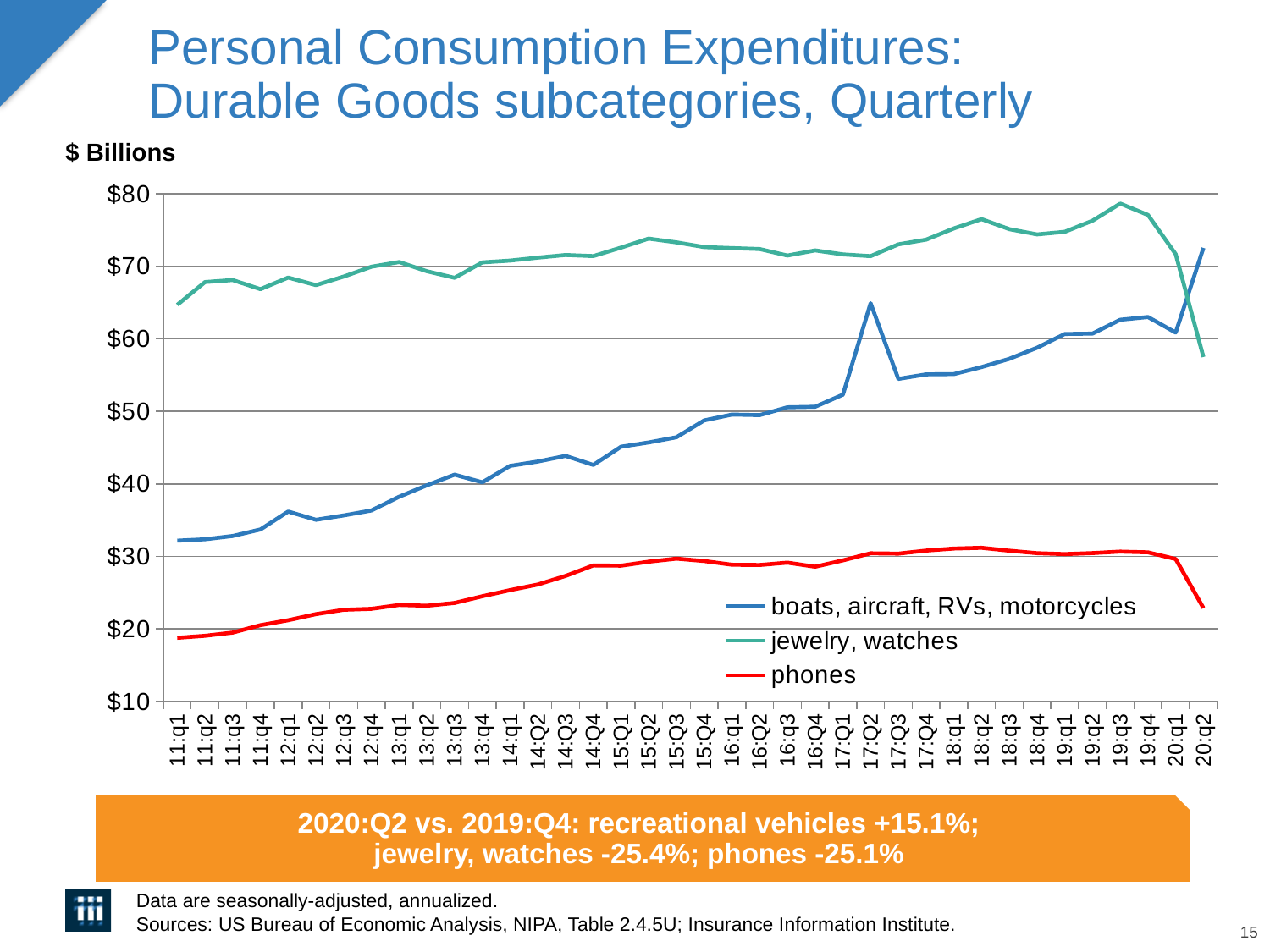
Is the value for phones in 11:q1 greater or less than $20? less Is the value for boats, aircraft, RVs, motorcycles in 17:Q2 greater or less than $60? greater Which series has the highest value in 11:q1? jewelry, watches What unit label is shown above the y axis of the chart? $ Billions Is the value for jewelry, watches in 19:q3 greater or less than $70? greater What kind of chart is shown on the slide? line chart How many quarterly points are plotted along the x axis, from 11:q1 to 20:q2? 38 In 20:q2, which is larger: boats, aircraft, RVs, motorcycles or jewelry, watches? boats, aircraft, RVs, motorcycles How many series does the legend list? 3 Does the jewelry, watches line rise or fall from 19:q3 to 20:q2? fall Which series has the lowest values across the whole period? phones